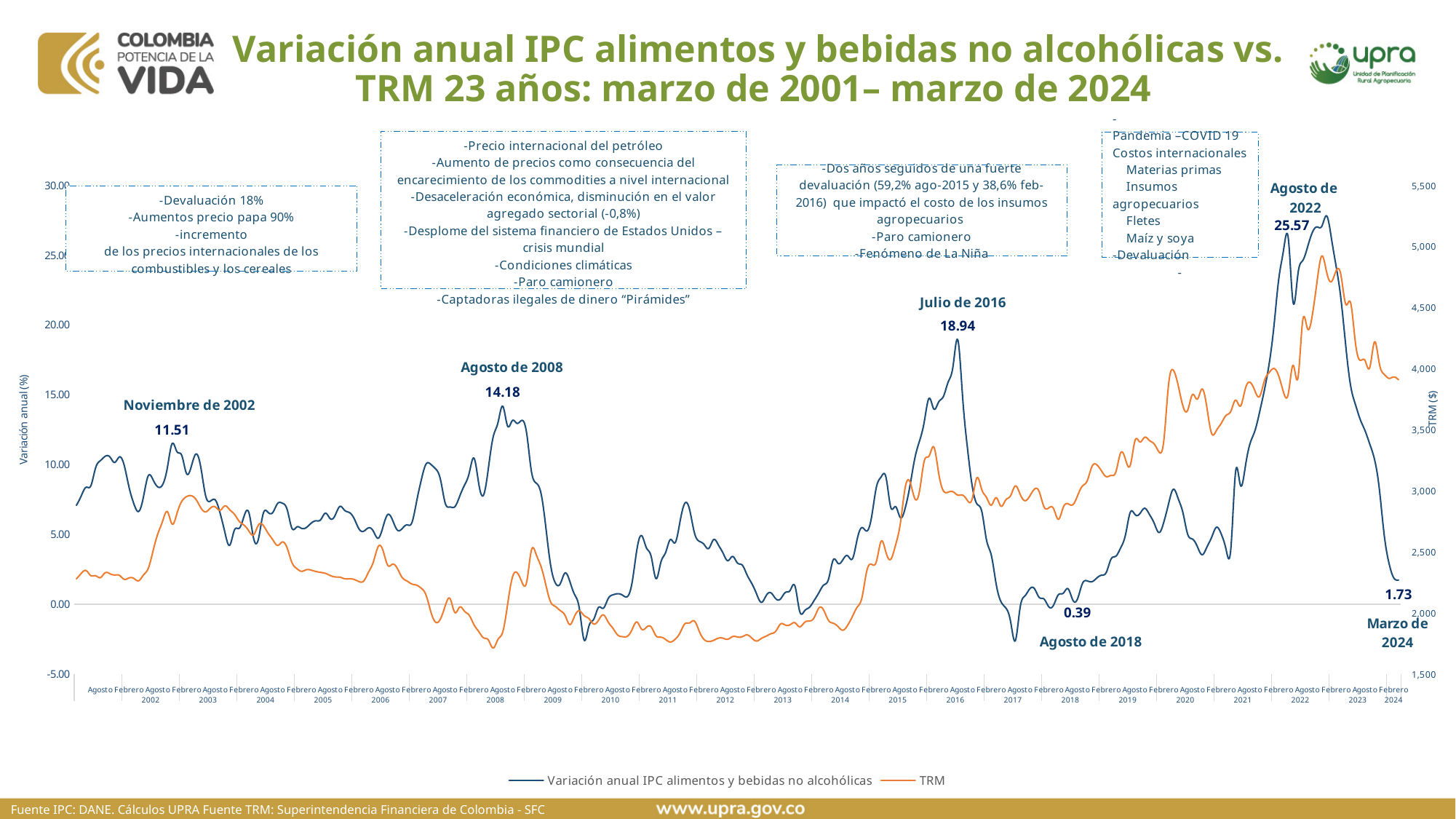
Which series is drawn in orange according to the legend? TRM How many series does the legend list? 2 What is the difference between the labelled IPC values for Agosto de 2022 and Julio de 2016? 6.63 Which labelled point has the highest annual IPC variation? Agosto de 2022 What is the labelled value of the annual IPC variation for Julio de 2016? 18.94 What is the labelled value of the annual IPC variation for Marzo de 2024? 1.73 What type of chart is shown on the slide? line chart What is the labelled value of the annual IPC variation for Noviembre de 2002? 11.51 What is the labelled value of the annual IPC variation for Agosto de 2018? 0.39 What is the labelled value of the annual IPC variation for Agosto de 2022? 25.57 Which labelled IPC value is larger: Agosto de 2008 or Noviembre de 2002? Agosto de 2008 Which labelled point has the lowest annual IPC variation? Agosto de 2018